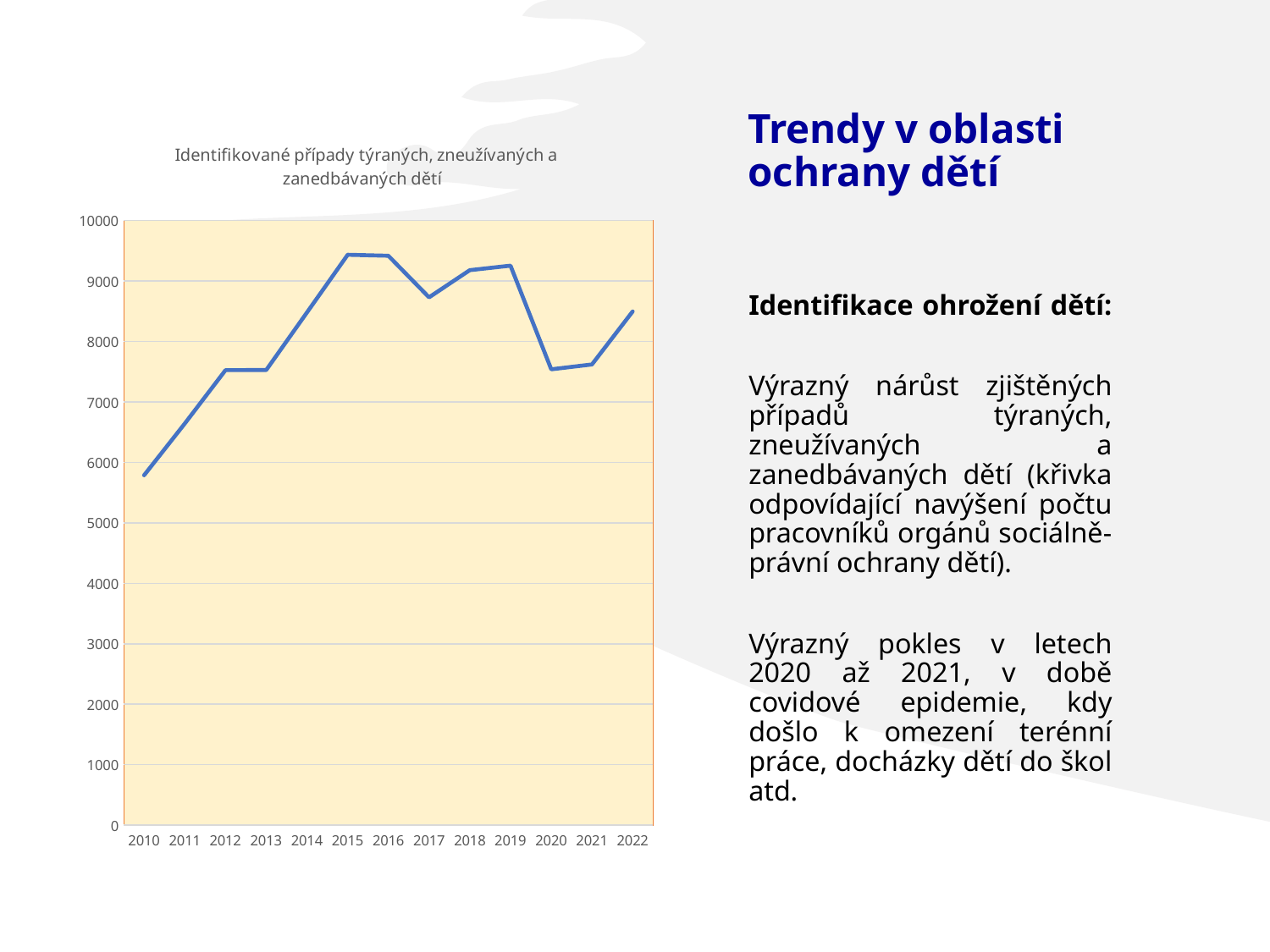
Is the value for 2015 greater or less than 9000? greater Which year has the larger value, 2015 or 2020? 2015 Is the value for 2020 greater or less than 7000? greater Which year has the larger value, 2010 or 2022? 2022 Do the values rise or fall from 2010 to 2015? rise Is the value for 2017 greater or less than 9000? less What kind of chart is shown on the slide? line chart Which year has the lowest value in the chart? 2010 How many years are plotted on the x axis of the chart? 13 What is the title of the chart? Identifikované případy týraných, zneužívaných a zanedbávaných dětí